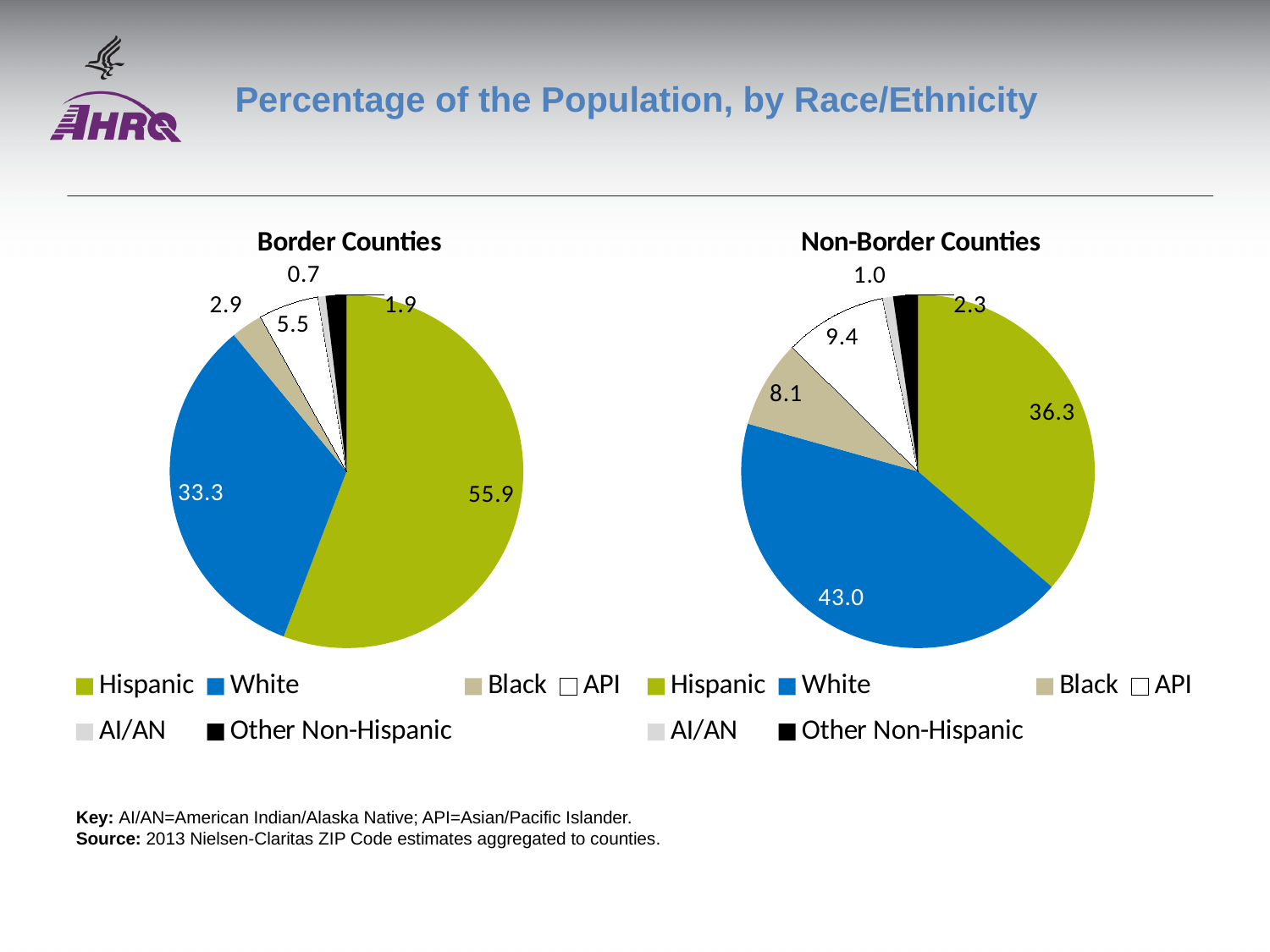
In the Border Counties chart, what is the value for Black? 2.9 In the Non-Border Counties chart, which race/ethnicity group has the largest share? White In the Non-Border Counties chart, what is the value for API? 9.4 In the Border Counties chart, which race/ethnicity group has the smallest share? AI/AN How many slices does the Border Counties pie chart have? 6 What is the difference between the Hispanic share in Border Counties and the Hispanic share in Non-Border Counties? 19.6 Is the Black share larger in the Border Counties chart or the Non-Border Counties chart? Non-Border Counties In the Non-Border Counties chart, what percentage of the population is White? 43.0 In the Non-Border Counties chart, what is the difference between the White and Hispanic shares? 6.7 What type of chart is used on this slide? Pie chart In the Border Counties chart, which race/ethnicity group has the largest share? Hispanic In the Border Counties chart, what percentage of the population is Hispanic? 55.9